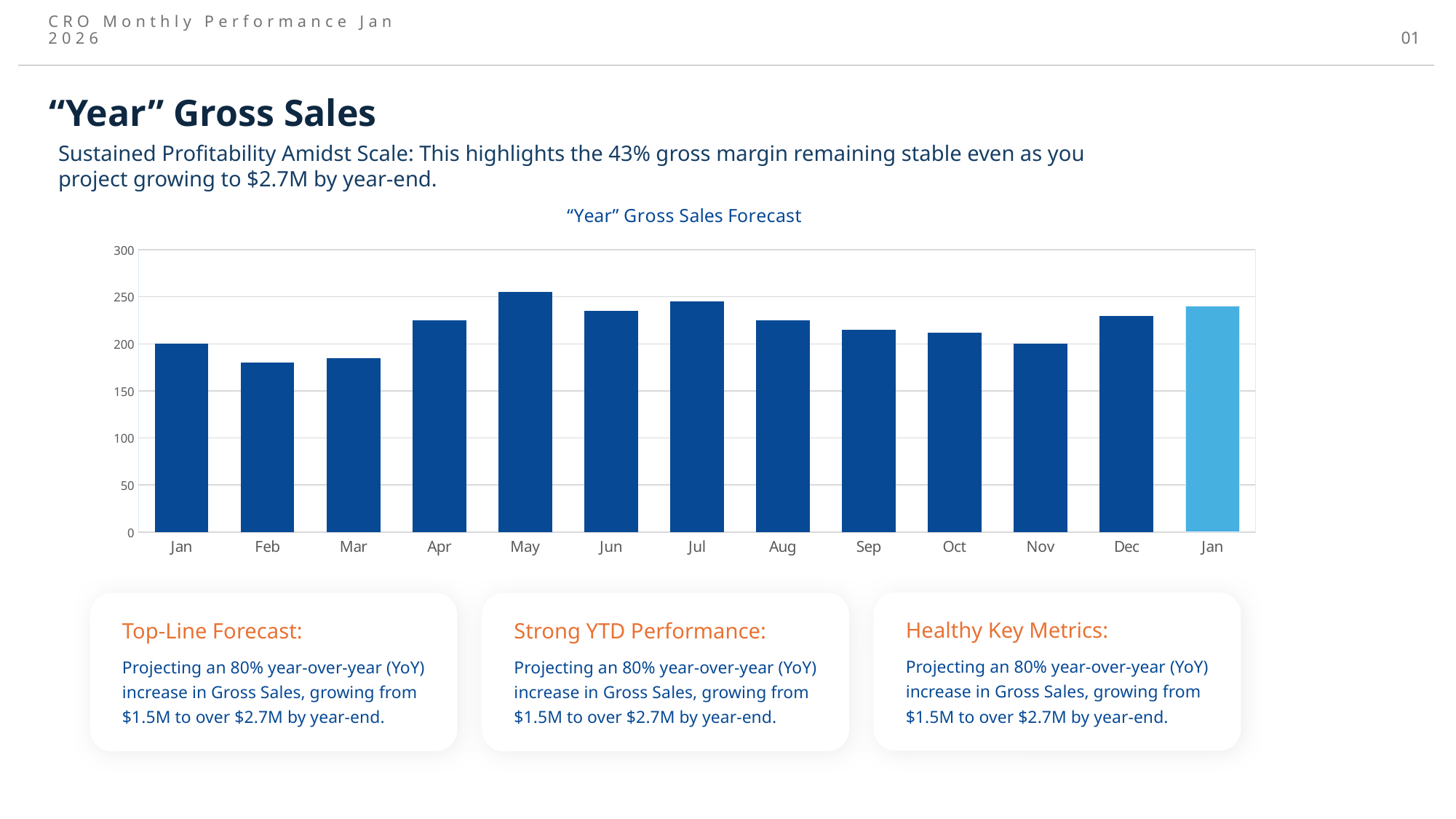
Which bar is shown in a lighter blue colour than the others? The last Jan bar Which is larger, the value for May or the value for Feb? May Which is larger, the value for Apr or the value for Mar? Apr How many bars are plotted in the chart? 13 Is the value for Apr greater or less than 200? greater Is the value for Feb greater or less than 200? less Which month has the highest bar in the chart? May What is the title of the chart? "Year" Gross Sales Forecast What kind of chart is shown on the slide? bar chart Which is larger, the value for Dec or the value for Nov? Dec